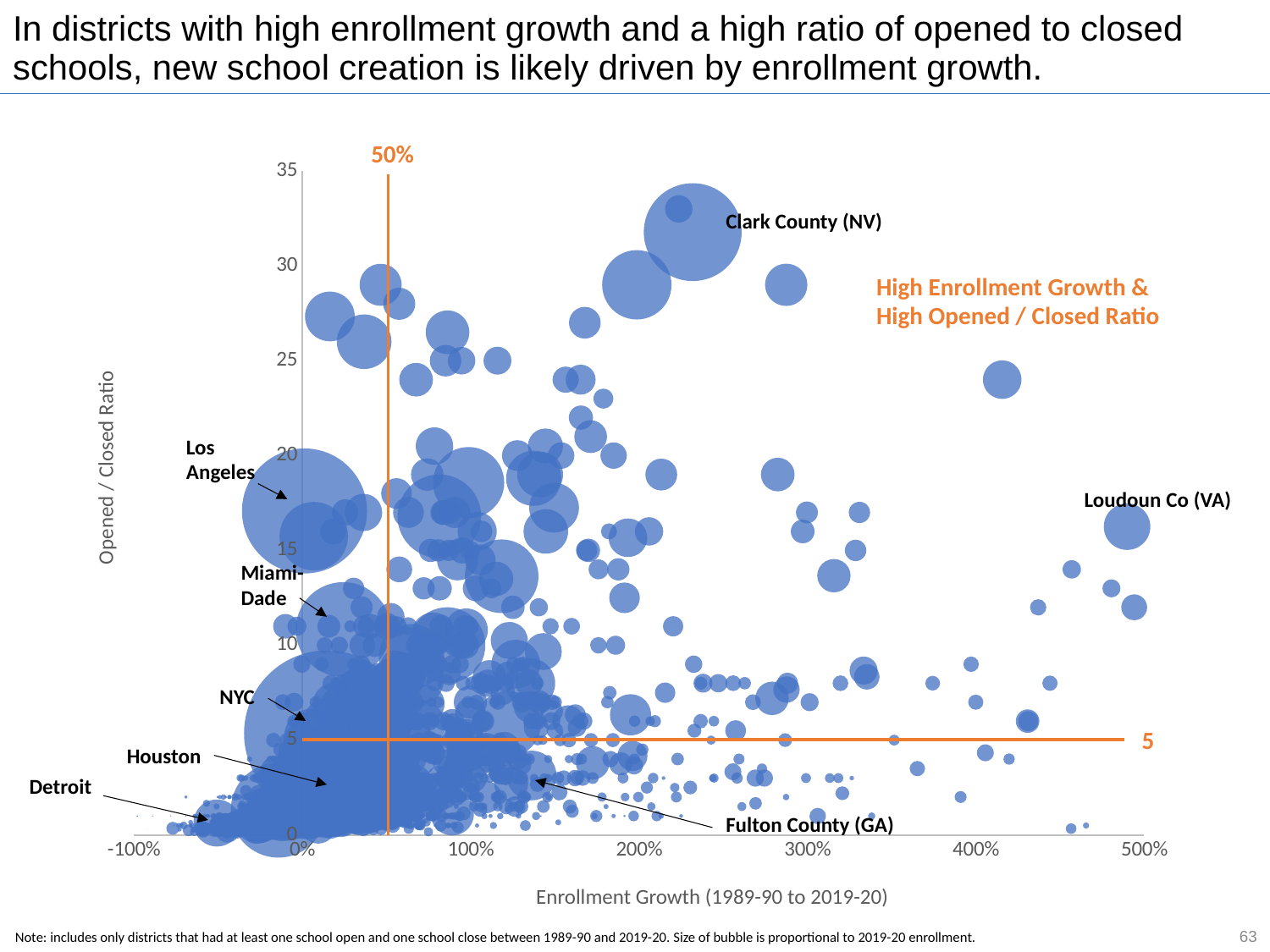
Is the Opened / Closed Ratio for Houston greater or less than 5? less Is the Opened / Closed Ratio for Los Angeles greater or less than 15? greater Which of the labeled districts has the lowest enrollment growth? Detroit What kind of chart is shown on the slide? Bubble chart At what enrollment growth value is the vertical orange reference line drawn? 50% Is the enrollment growth for Detroit greater or less than 0%? less Which of the labeled districts has the highest Opened / Closed Ratio? Clark County (NV) What is the title of the x axis? Enrollment Growth (1989-90 to 2019-20) Which has the higher enrollment growth, Clark County (NV) or Loudoun Co (VA)? Loudoun Co (VA)